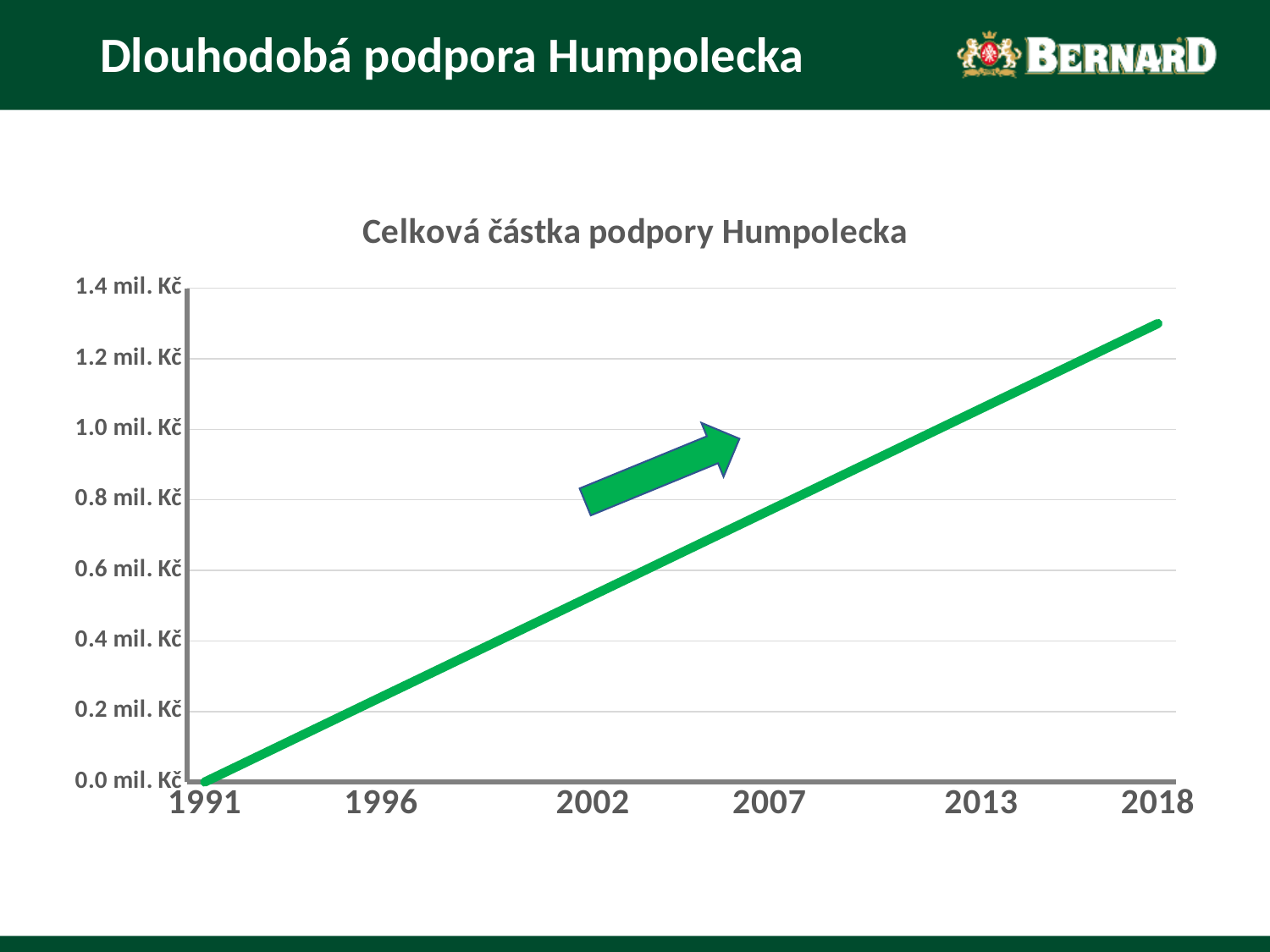
Does the value rise or fall from 1991 to 2018? rise Is the value for 2002 greater or less than 0.4 mil. Kč? greater What is the title of the chart? Celková částka podpory Humpolecka Is the value for 2013 greater or less than 0.8 mil. Kč? greater Which is larger, the value for 2007 or the value for 2013? 2013 Is the value for 1996 greater or less than 0.4 mil. Kč? less Which year on the x axis has the highest value? 2018 How many year labels are shown on the x axis? 6 What is the value for 1991? 0.0 mil. Kč What kind of chart is shown on the slide? line chart Which year on the x axis has the lowest value? 1991